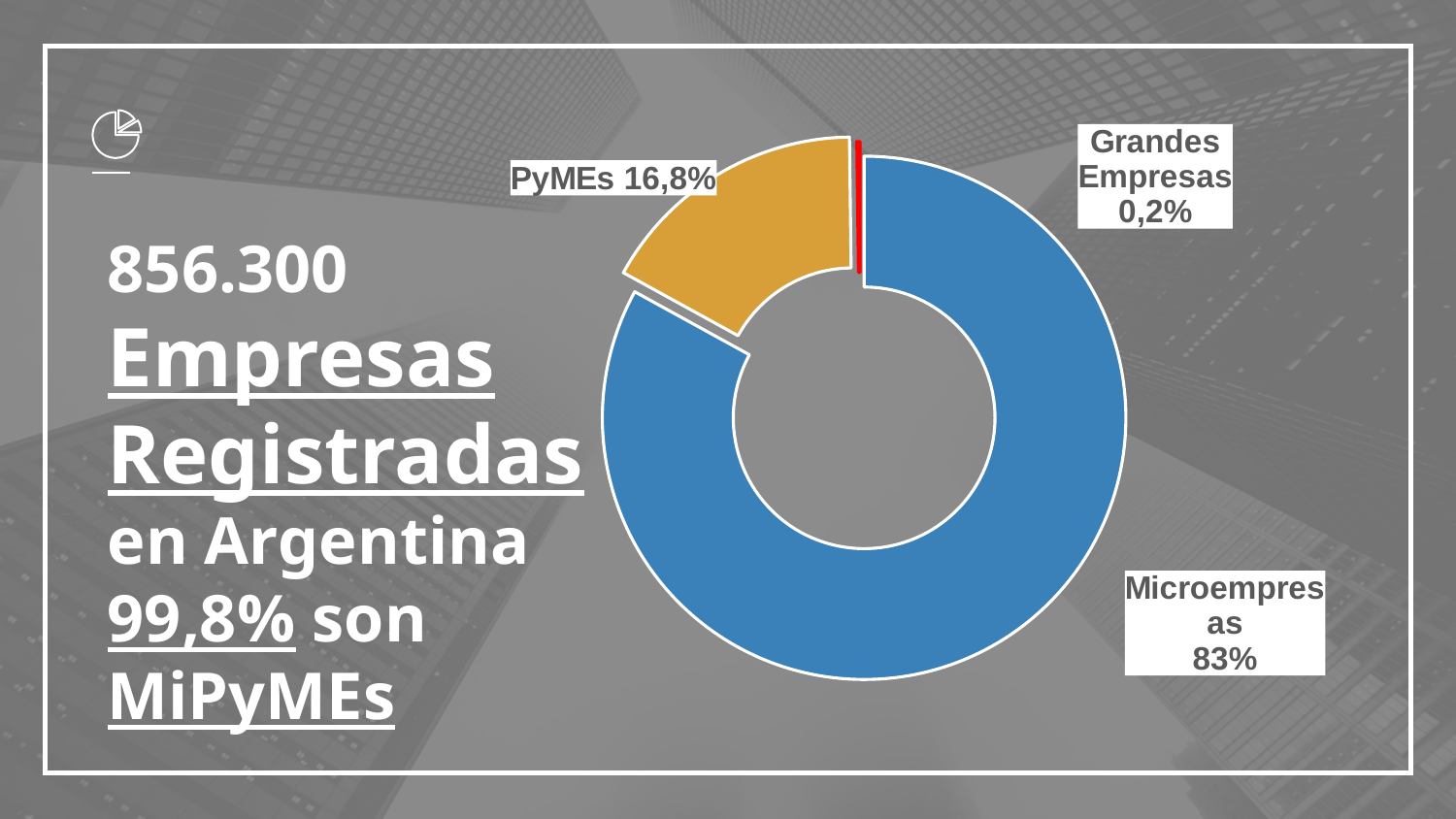
What share of the doughnut chart is labelled for Grandes Empresas? 0,2% Which slice is larger, PyMEs or Grandes Empresas? PyMEs Which category has the largest slice in the chart? Microempresas What share of the doughnut chart is labelled for Microempresas? 83% What colour is the PyMEs slice? Orange Which category has the smallest slice in the chart? Grandes Empresas What is the difference in percentage points between the PyMEs slice and the Grandes Empresas slice? 16,6 How many slices does the chart have? 3 What kind of chart is shown on the slide? Doughnut (pie) chart What colour is the Microempresas slice? Blue What share of the doughnut chart is labelled for PyMEs? 16,8% What is the difference in percentage points between the Microempresas slice and the PyMEs slice? 66,2